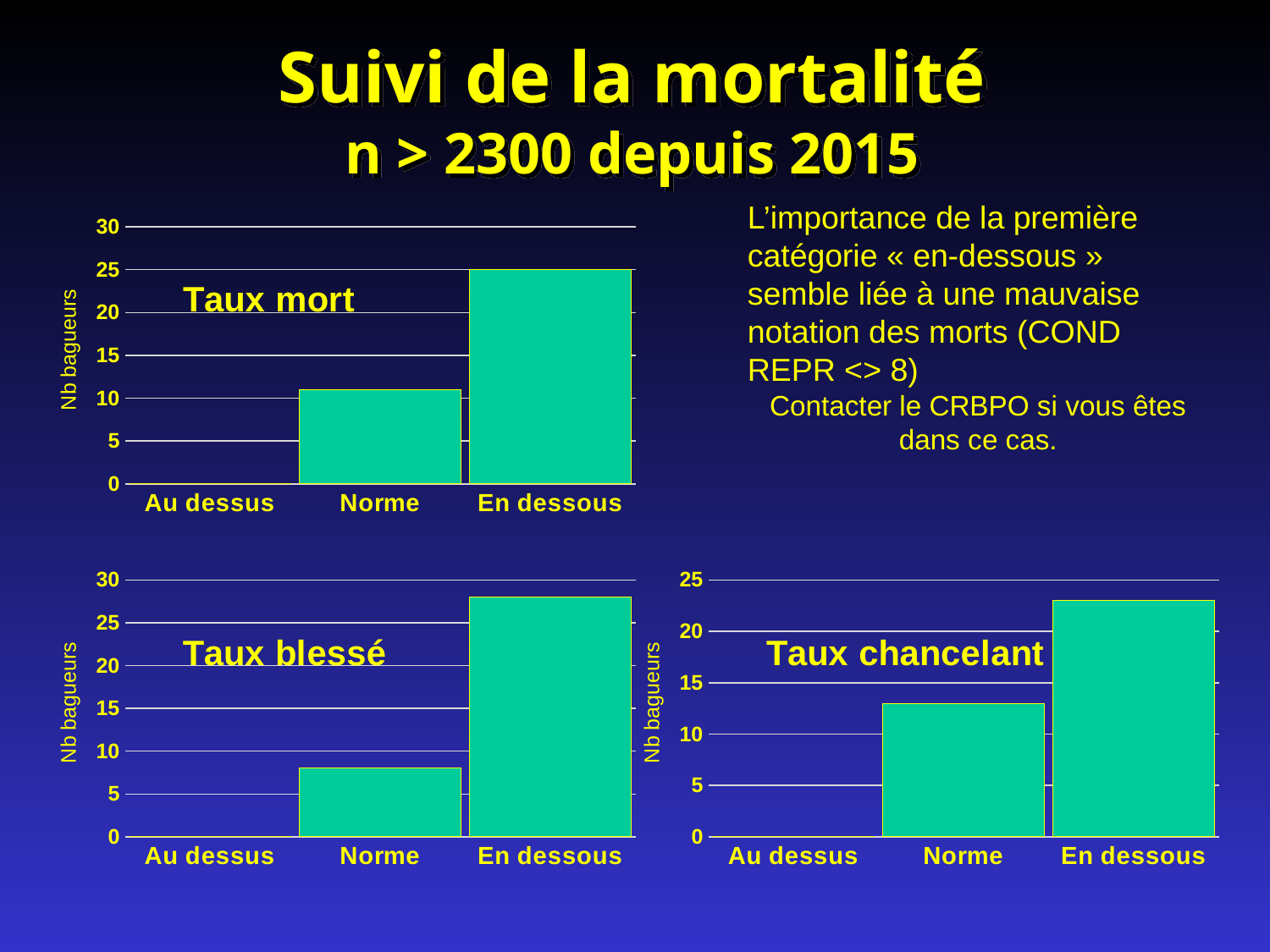
In the "Taux chancelant" chart, do the values rise or fall from Au dessus to En dessous along the x axis? rise In the "Taux mort" chart, how many categories are shown on the x axis? 3 In the "Taux blessé" chart, is the value for En dessous greater or less than 25? greater What is the y-axis label on the "Taux blessé" chart? Nb bagueurs In the "Taux blessé" chart, which is larger, the value for Norme or the value for En dessous? En dessous In the "Taux chancelant" chart, is the value for En dessous greater or less than 20? greater What kind of chart is the "Taux mort" chart? bar chart In the "Taux blessé" chart, is the value for Norme greater or less than 10? less In the "Taux mort" chart, which category has the highest value? En dessous